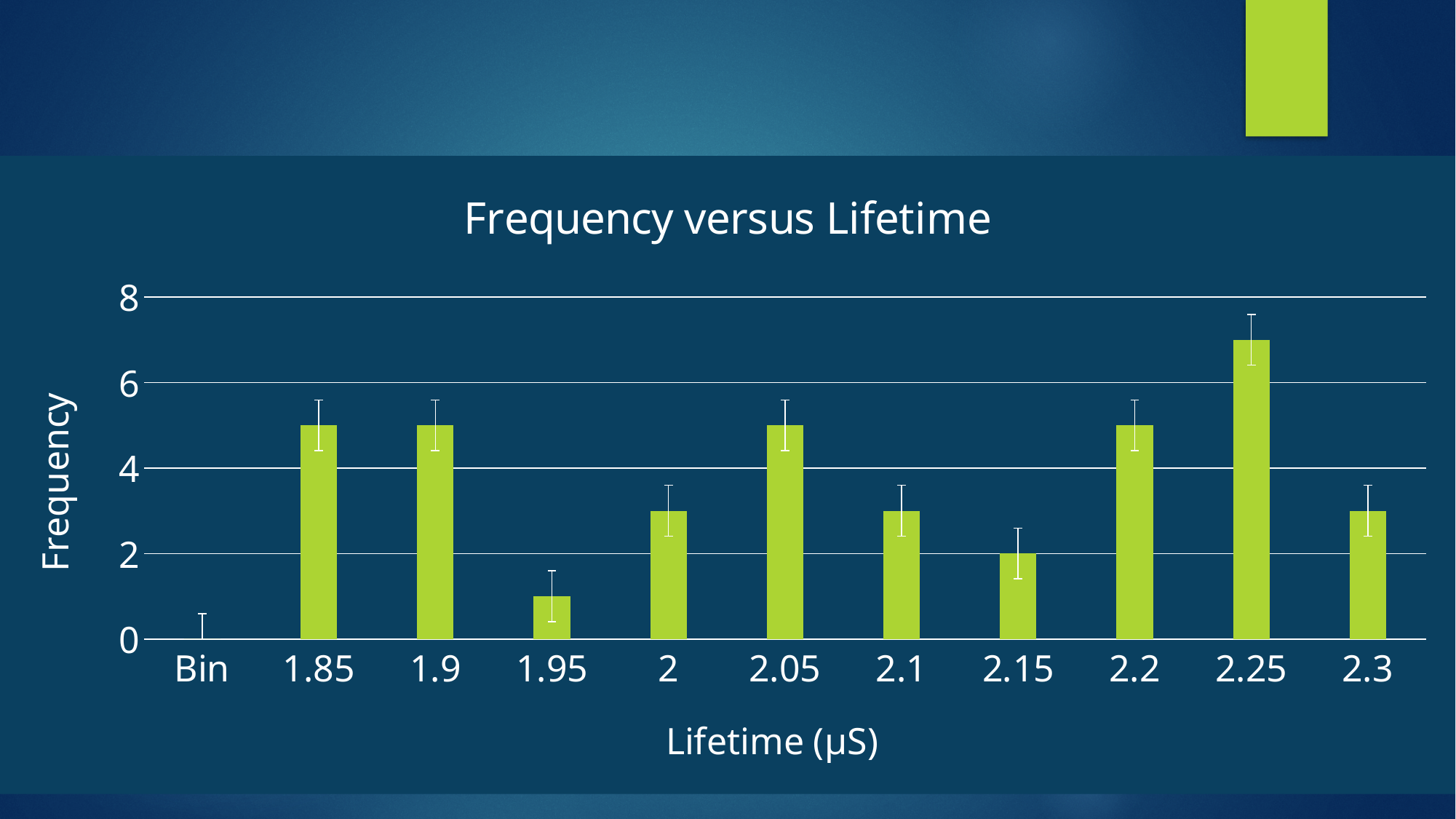
What is the title of the chart? Frequency versus Lifetime Is the frequency for 1.95 greater or less than 2? less Which category has the highest frequency? 2.25 Is the frequency for 2.3 greater or less than 4? less Which has the larger frequency, 1.95 or 2? 2 Which has the larger frequency, 2.2 or 2.25? 2.25 Is the frequency for 2.25 greater or less than 6? greater What kind of chart is shown on the slide? bar chart What is the label of the x axis? Lifetime (µS) How many categories are shown on the x axis? 11 What is the frequency for the 2.15 category? 2